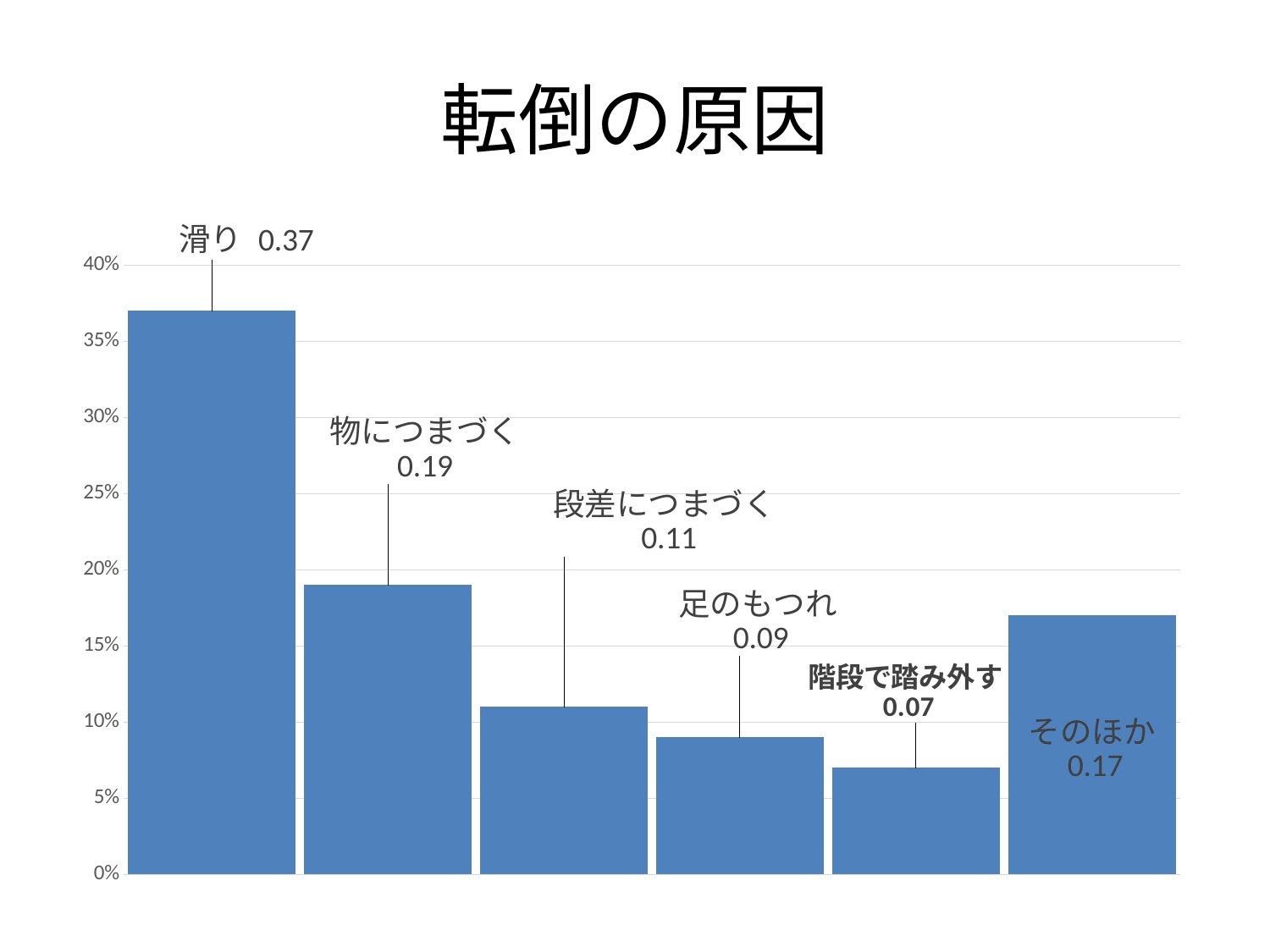
Which category has the lowest value? 階段で踏み外す Which category has the highest value? 滑り Is the value for 足のもつれ greater or less than 10%? less What is the difference between the values for 滑り and 物につまづく? 0.18 What kind of chart is shown on the slide? bar chart What is the title of the chart? 転倒の原因 How many categories are shown in the chart? 6 What is the value shown for 階段で踏み外す? 0.07 Which is larger, the value for そのほか or the value for 段差につまづく? そのほか What is the value shown for 滑り? 0.37 What is the value shown for 物につまづく? 0.19 What is the value shown for そのほか? 0.17